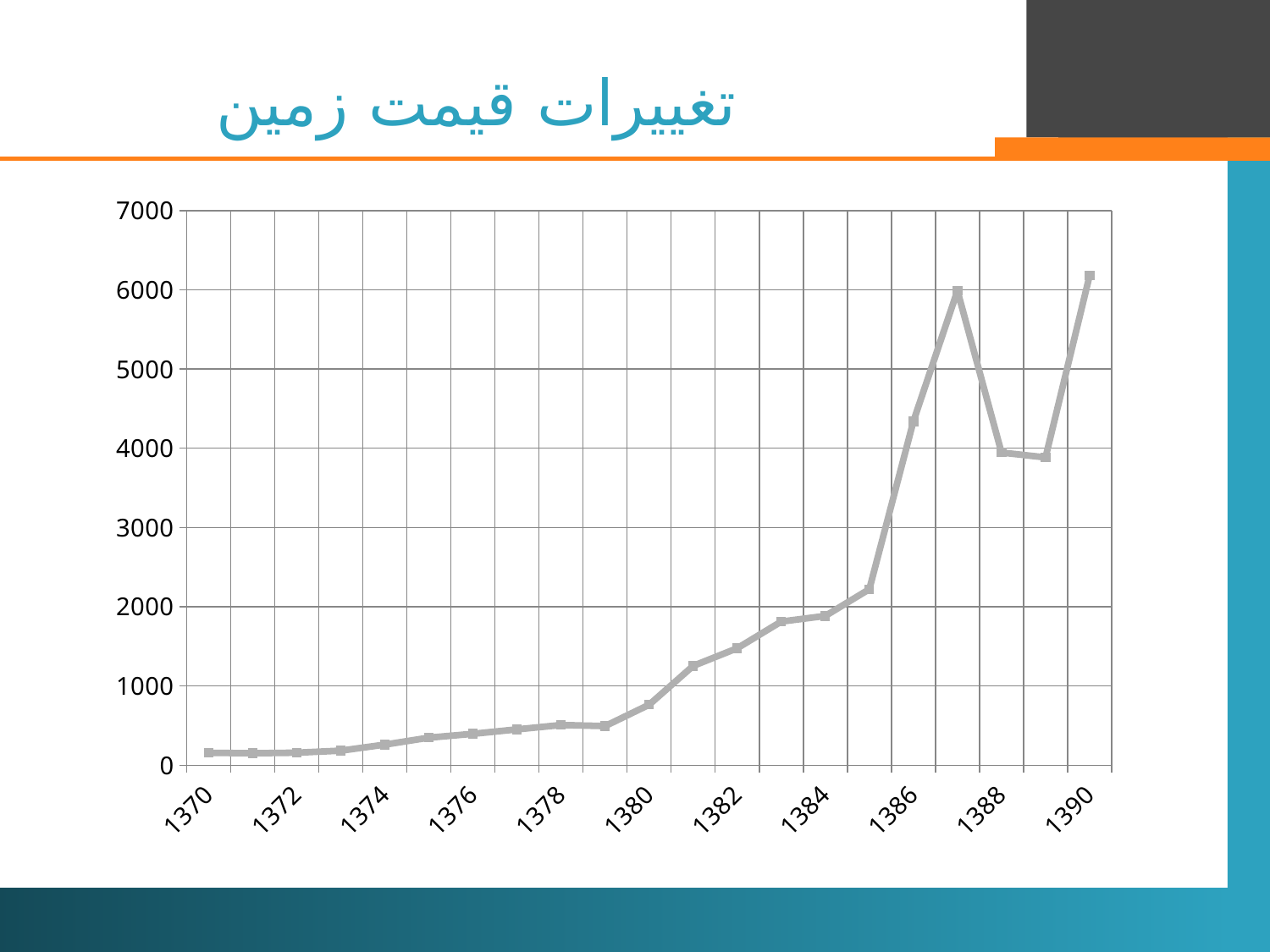
What is the title of the chart? تغییرات قیمت زمین Is the value for 1387 greater or less than 5000? greater Which has the larger value, 1386 or 1388? 1386 What kind of chart is shown on the slide? line chart Is the value for 1380 greater or less than 1000? less Is the value for 1385 greater or less than 2000? greater Do the values generally rise or fall from 1370 to 1387? rise Which has the larger value, 1387 or 1389? 1387 What is the highest value shown on the vertical axis? 7000